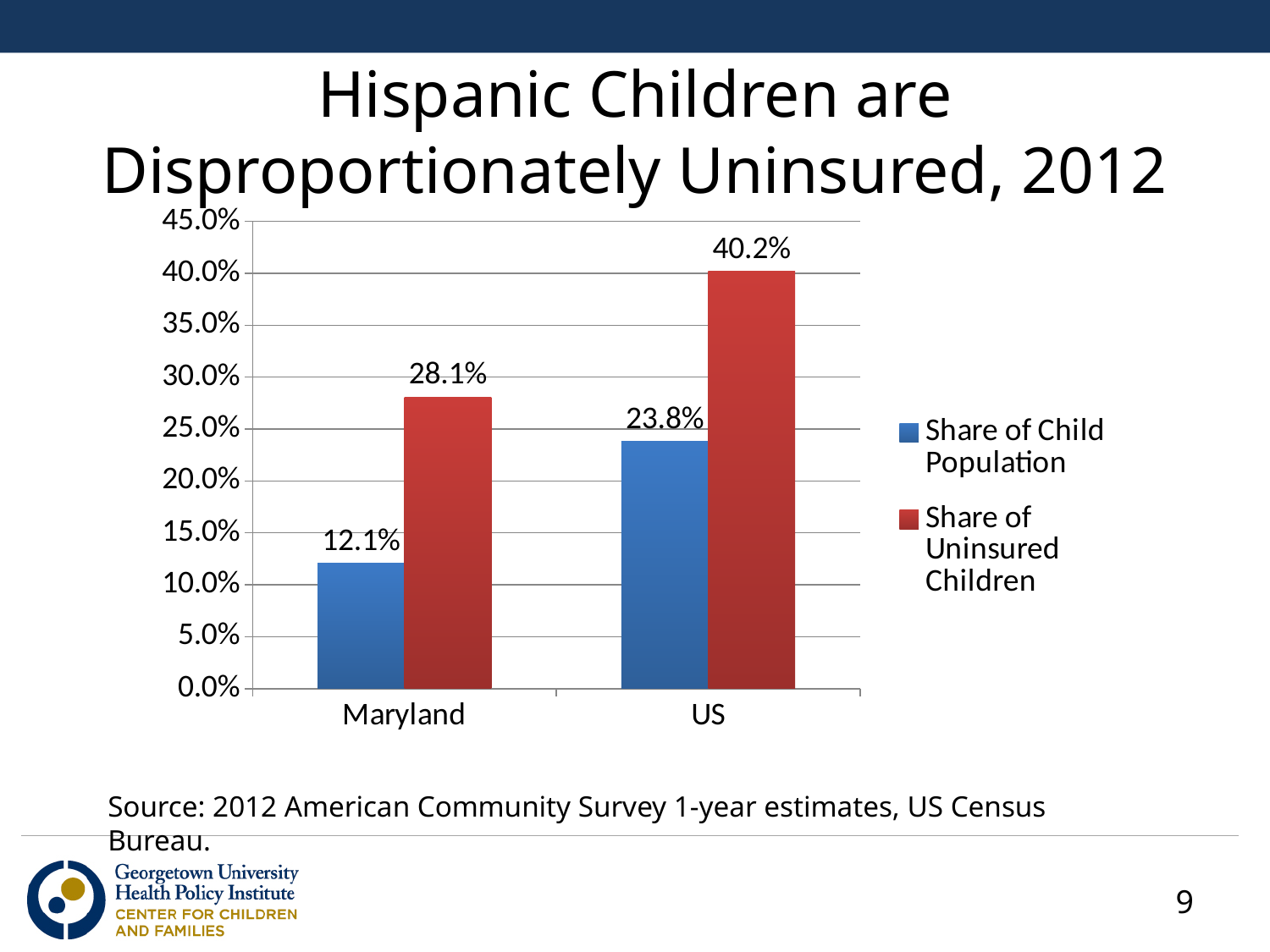
What is the Share of Child Population for Maryland? 12.1% What is the difference between the Share of Uninsured Children and the Share of Child Population for the US? 16.4% How many series does the legend list? 2 How many categories are shown on the x axis? 2 Which category has the highest Share of Uninsured Children? US What is the difference between the Share of Uninsured Children and the Share of Child Population for Maryland? 16.0% Which is larger for the US: Share of Child Population or Share of Uninsured Children? Share of Uninsured Children What is the Share of Uninsured Children for the US? 40.2% Which category has the lowest Share of Child Population? Maryland What is the Share of Child Population for the US? 23.8% What kind of chart is shown on the slide? Bar chart What is the Share of Uninsured Children for Maryland? 28.1%